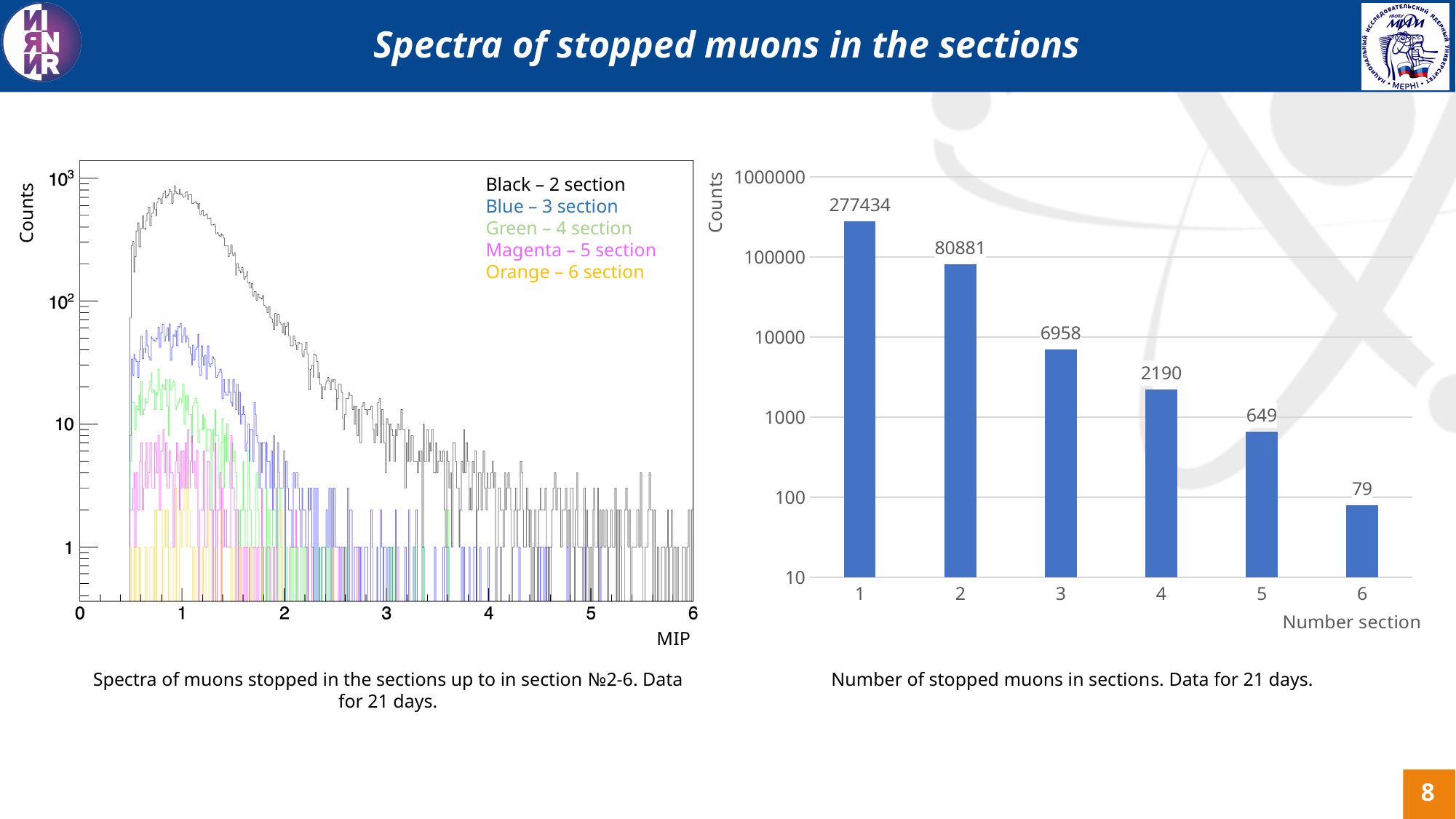
In the bar chart on the right, what is the number of stopped muons in section 3? 6958 What kind of chart is the chart on the right of the slide? bar chart In the bar chart on the right, which has a larger count, section 2 or section 3? section 2 In the bar chart on the right, what is the difference between the counts for section 4 and section 5? 1541 In the bar chart on the right, how many sections are shown on the x axis? 6 In the bar chart on the right, what is the number of stopped muons in section 6? 79 In the bar chart on the right, which section has the lowest number of stopped muons? 6 In the spectra chart on the left, which colour represents section 5? Magenta In the bar chart on the right, what is the number of stopped muons in section 1? 277434 In the bar chart on the right, what is the difference between the counts for section 1 and section 2? 196553 In the bar chart on the right, which section has the highest number of stopped muons? 1 In the bar chart on the right, do the counts rise or fall as the section number increases? fall